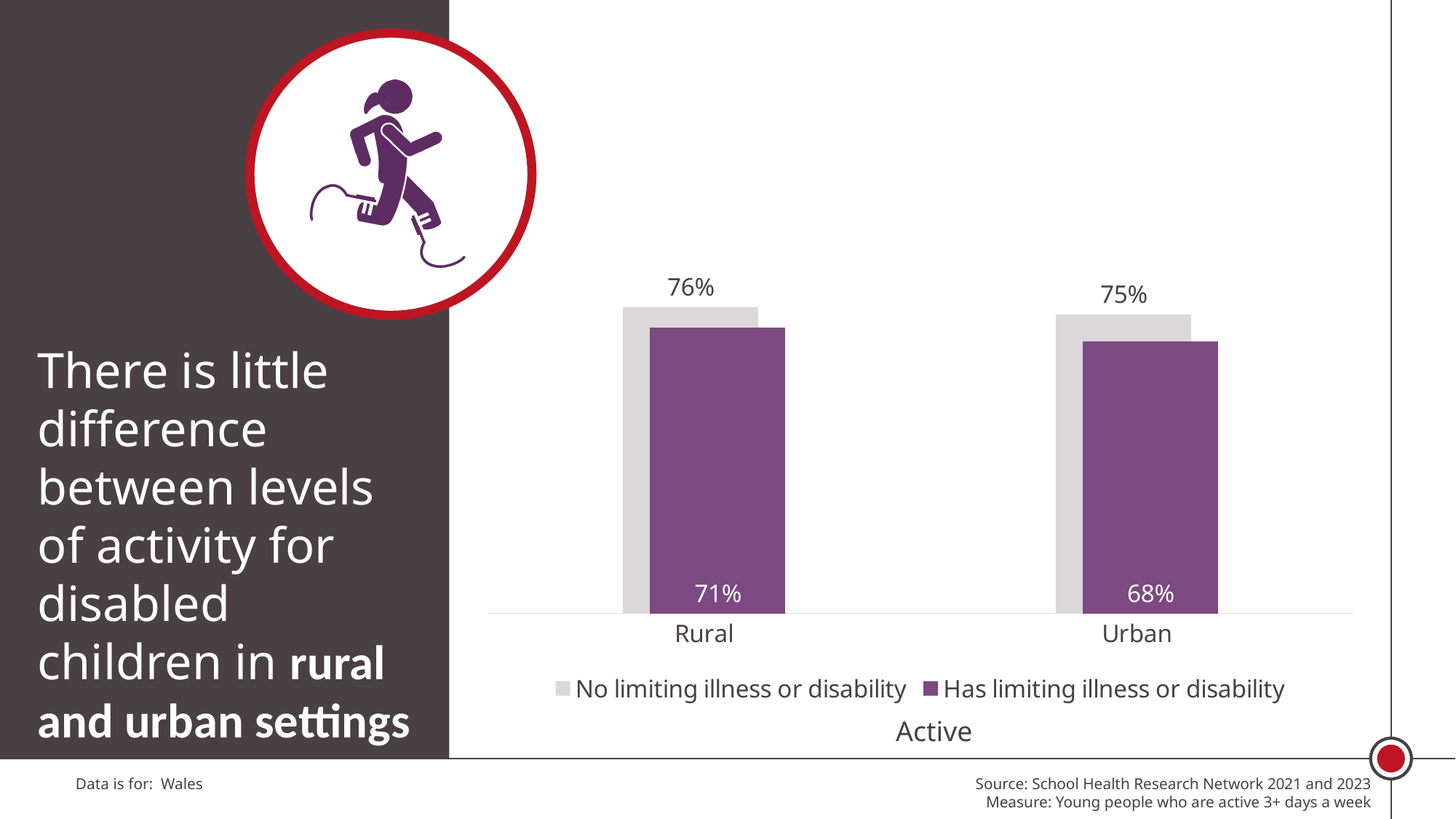
What is the value for 'No limiting illness or disability' in the Urban category? 75% Which is larger: the 'Has limiting illness or disability' value for Rural or for Urban? Rural What kind of chart is shown on the slide? Bar chart What percentage of rural young people with no limiting illness or disability are active? 76% What percentage of urban young people who have a limiting illness or disability are active? 68% Which category has the lowest value for 'Has limiting illness or disability'? Urban Which colour represents 'Has limiting illness or disability' in the legend? Purple What is the difference between the two series in the Urban category? 7 percentage points What is the value for 'Has limiting illness or disability' in the Rural category? 71% What is the difference between the two series in the Rural category? 5 percentage points How many series does the legend list? 2 How many categories are shown on the x axis? 2